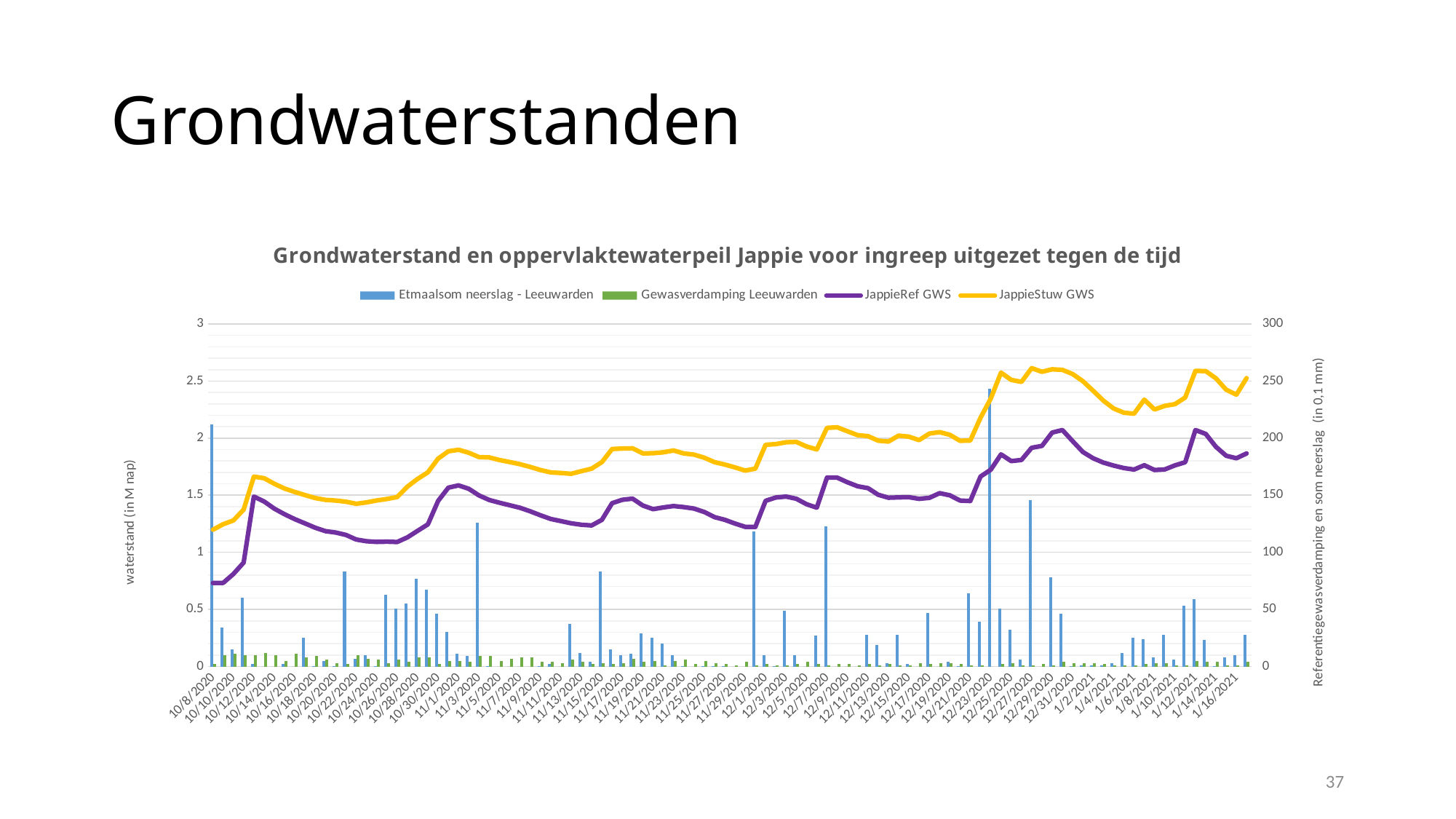
Does the JappieStuw GWS line overall rise or fall from 10/8/2020 to 1/16/2021? rise Which line is higher throughout the chart, JappieStuw GWS or JappieRef GWS? JappieStuw GWS Is the JappieStuw GWS value on 11/1/2020 greater or less than 1.5? greater What is the title of the chart? Grondwaterstand en oppervlaktewaterpeil Jappie voor ingreep uitgezet tegen de tijd Which series is drawn as a yellow line? JappieStuw GWS Is the JappieStuw GWS value on 10/8/2020 greater or less than 1.5? less Is the tallest Etmaalsom neerslag - Leeuwarden bar greater or less than 200 on the right axis? greater What kind of chart is this? A combined bar and line chart What is the maximum value shown on the right-hand axis? 300 How many series does the chart legend list? 4